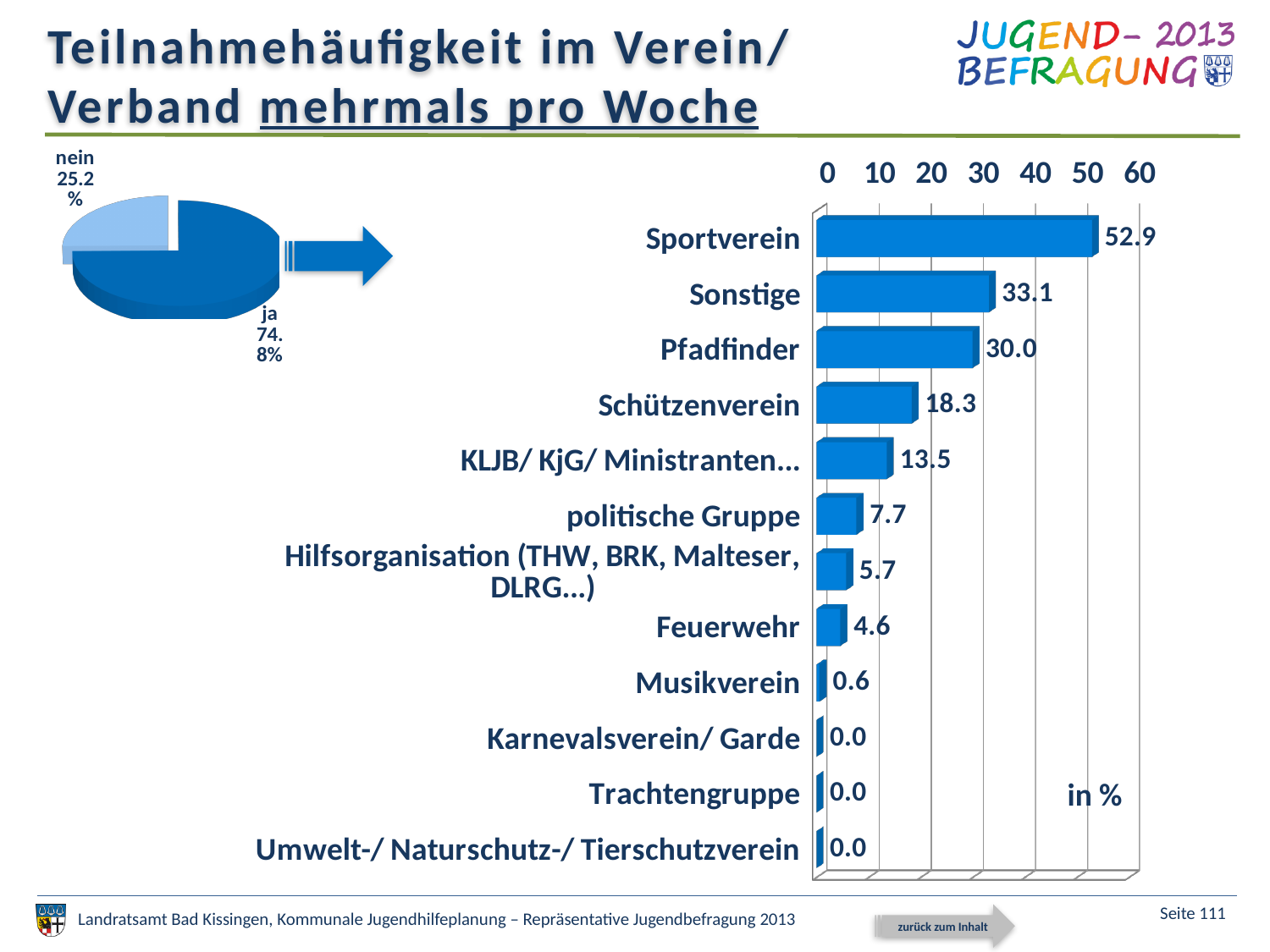
In the bar chart, what is the value for Feuerwehr? 4.6 In the bar chart, which is larger: the value for politische Gruppe or the value for Hilfsorganisation (THW, BRK, Malteser, DLRG...)? politische Gruppe In the bar chart, what is the value for Pfadfinder? 30.0 In the pie chart on the left, what share does the 'nein' slice have? 25.2% In the bar chart, what is the value for Musikverein? 0.6 In the bar chart, what is the difference between the values for Sportverein and Sonstige? 19.8 In the bar chart, which category has the highest value? Sportverein In the pie chart on the left, what share does the 'ja' slice have? 74.8% In the bar chart, what is the value for Sportverein? 52.9 What kind of chart is the chart on the right side of the slide? bar chart In the bar chart, what is the difference between the values for Pfadfinder and Schützenverein? 11.7 In the bar chart, how many categories are shown? 12